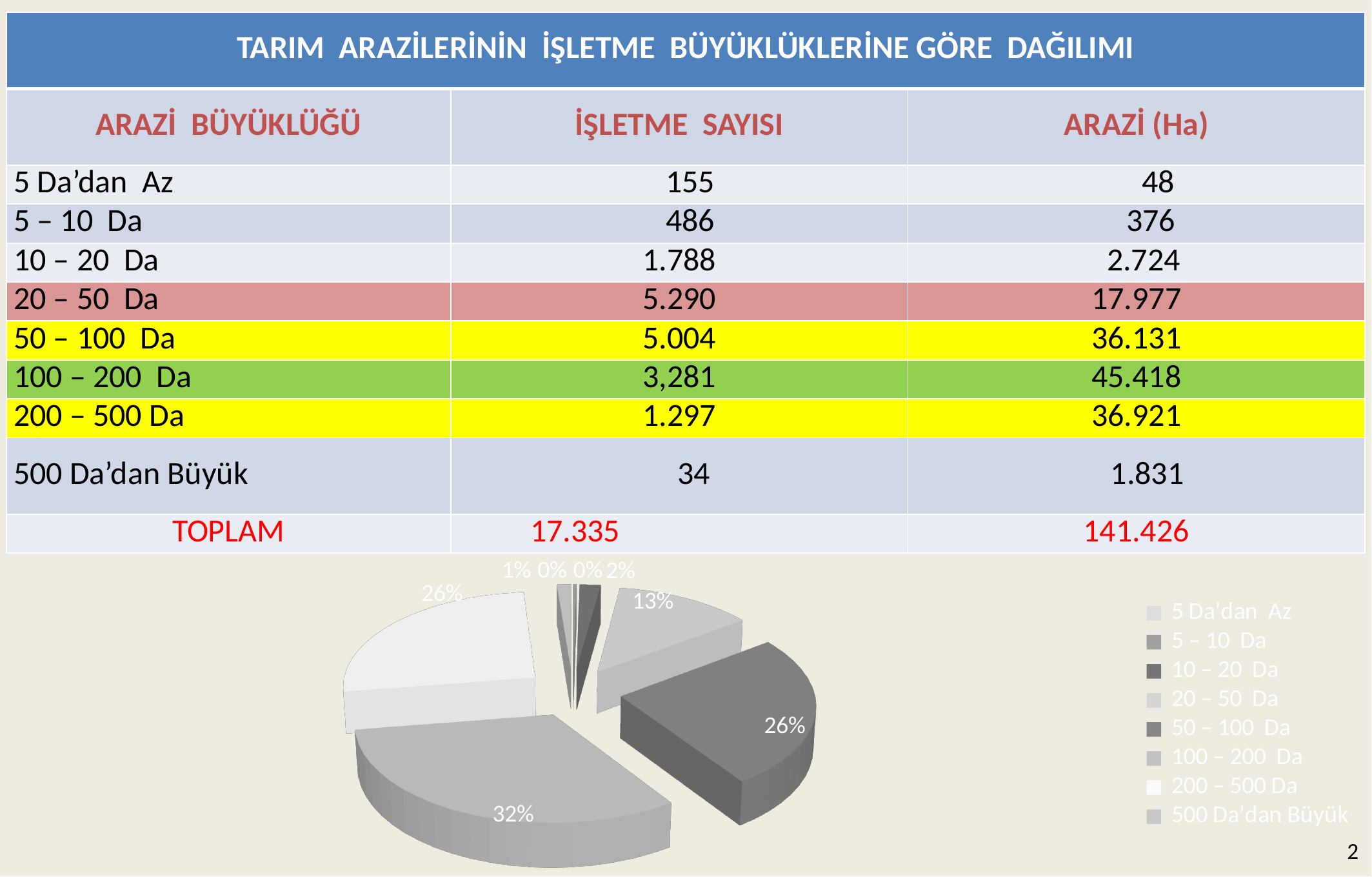
Which is larger on the pie chart, the slice labelled 32% or the slice labelled 13%? 32% What is the smallest percentage shown on the pie chart? 0% What is the largest percentage shown on the pie chart? 32% What is the first entry listed in the pie chart's legend? 5 Da'dan Az What is the difference in percentage points between the 32% slice and the 13% slice on the pie chart? 19 How many slices of the pie chart are labelled 0%? 2 What is the difference in percentage points between the 13% slice and the 2% slice on the pie chart? 11 What kind of chart is shown at the bottom of the slide? Pie chart How many entries does the legend of the pie chart list? 8 How many slices of the pie chart are labelled 26%? 2 How many slices are labelled on the pie chart? 8 What is the last entry listed in the pie chart's legend? 500 Da'dan Büyük